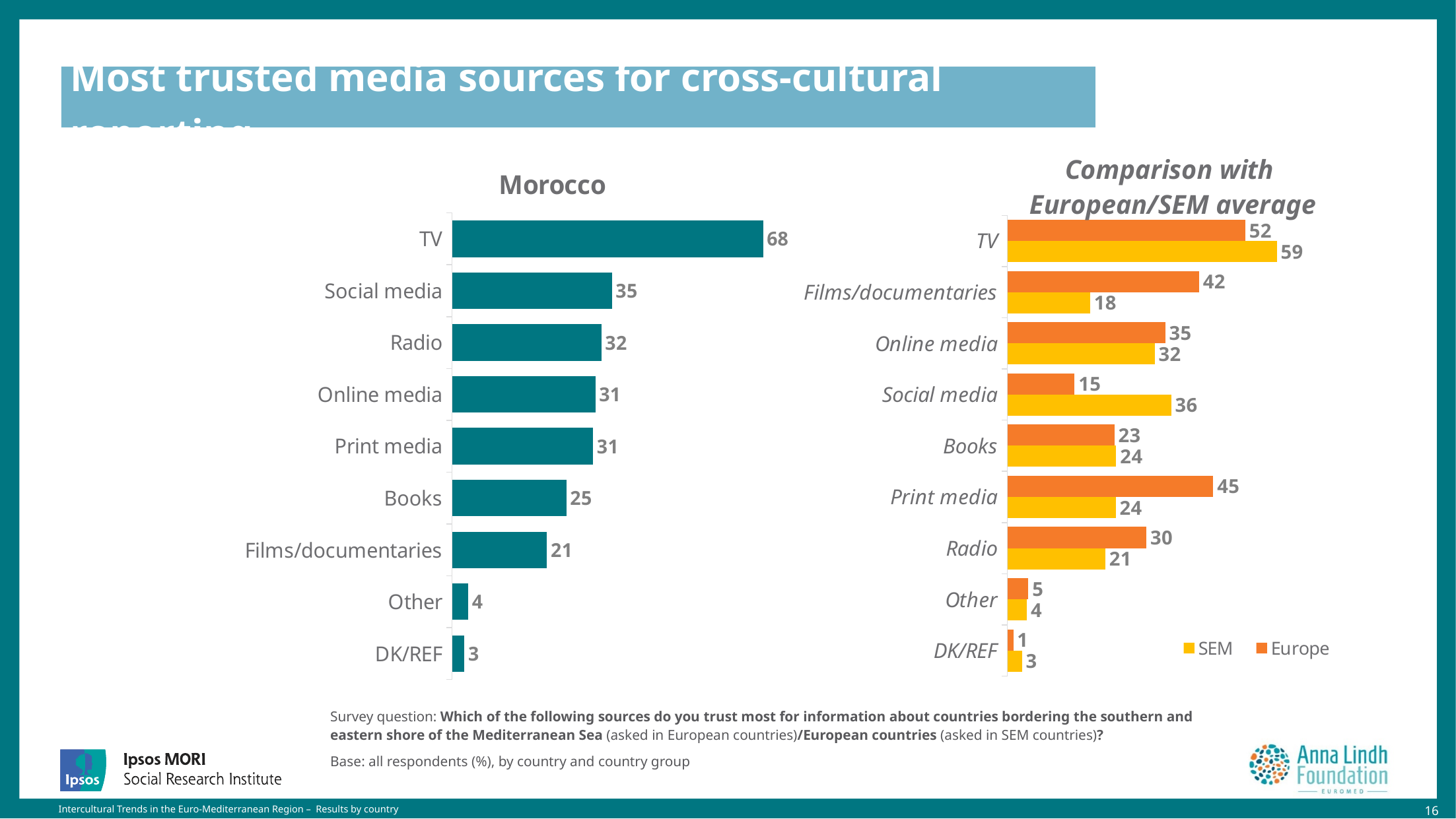
In the Comparison with European/SEM average chart, which is larger for Print media, Europe or SEM? Europe In the Morocco chart, what is the difference between Social media and Radio? 3 In the Comparison with European/SEM average chart, what is the SEM value for Social media? 36 In the Comparison with European/SEM average chart, which colour represents SEM? yellow In the Morocco chart, which category has the lowest value? DK/REF In the Morocco chart, what is the value for TV? 68 In the Morocco chart, how many categories are shown? 9 In the Comparison with European/SEM average chart, what is the Europe value for Films/documentaries? 42 In the Comparison with European/SEM average chart, what is the difference between the Europe and SEM values for TV? 7 In the Morocco chart, what is the value for Films/documentaries? 21 What kind of chart is the Morocco chart? bar chart How many series does the legend of the Comparison with European/SEM average chart list? 2